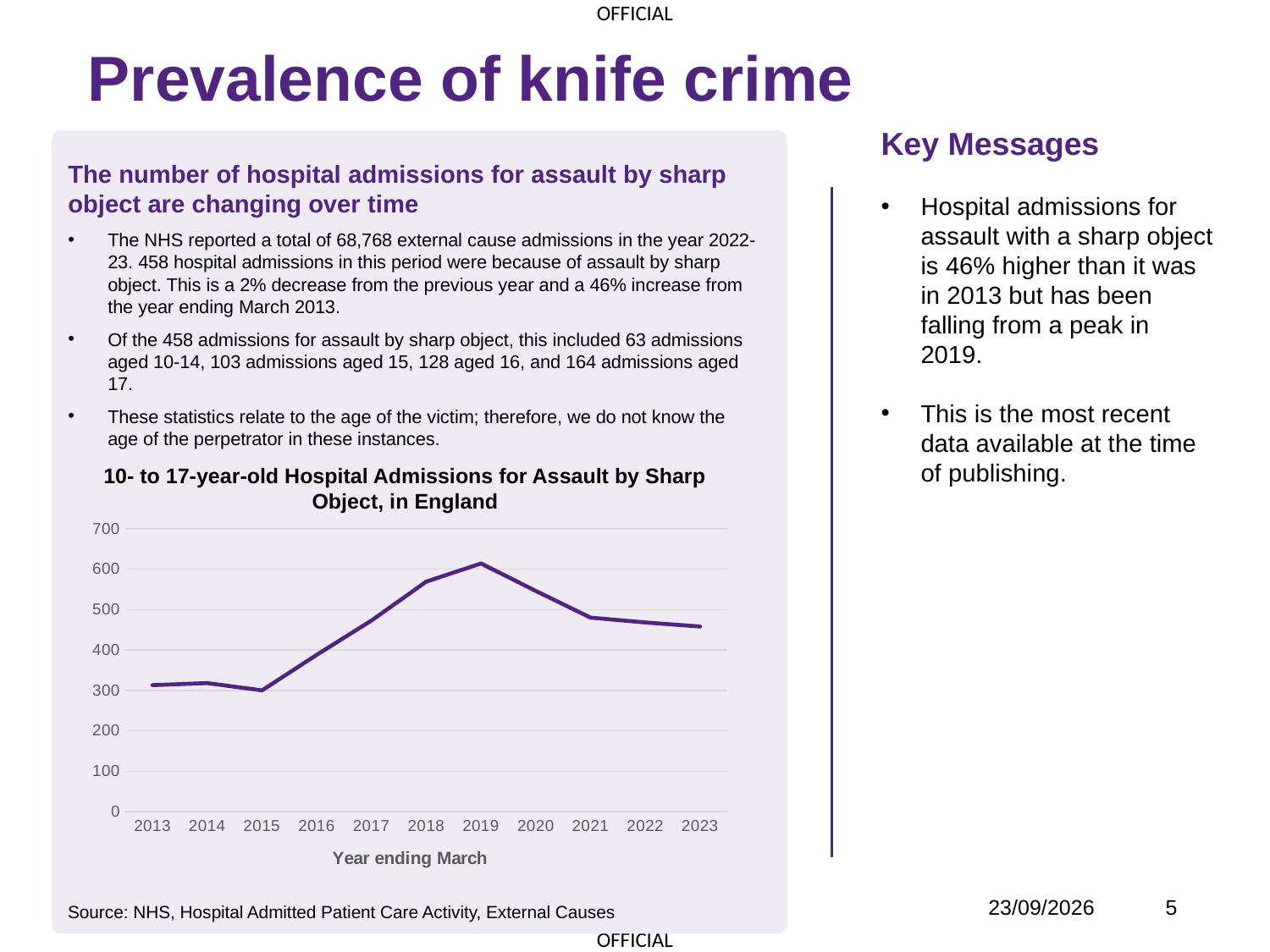
What kind of chart is shown on the slide? line chart Is the value for 2020 greater or less than 500? greater What is the title of the chart? 10- to 17-year-old Hospital Admissions for Assault by Sharp Object, in England Is the value for 2023 greater or less than 500? less Do the values rise or fall between 2019 and 2023? fall In which year does the line reach its highest value? 2019 What is the label on the x axis of the chart? Year ending March How many years are plotted on the x axis of the chart? 11 Which year has the higher value, 2018 or 2021? 2018 In which year does the line reach its lowest value? 2015 Is the value for 2019 greater or less than 600? greater